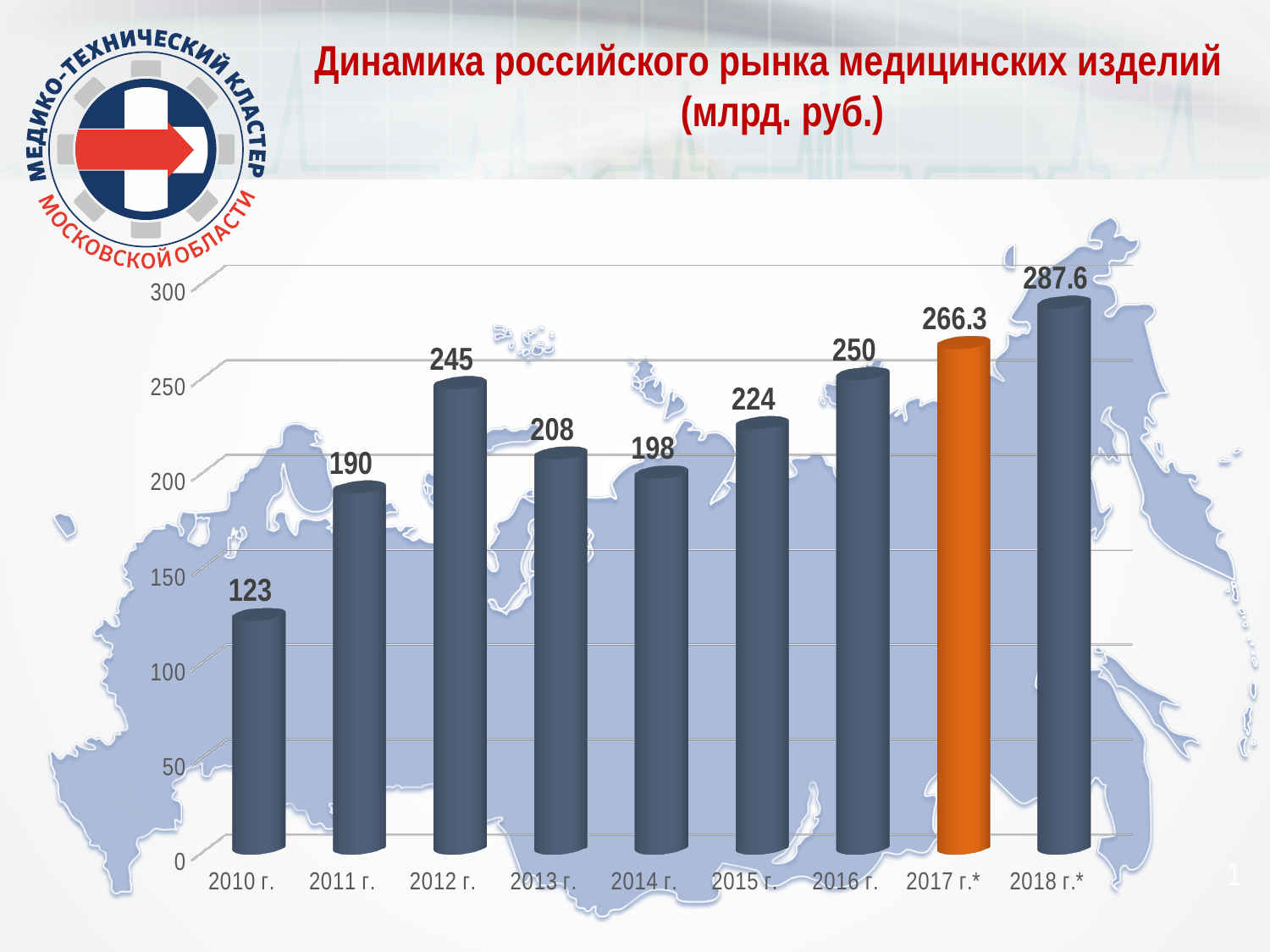
What is the value for 2010 г.? 123 Which bar is coloured orange instead of dark blue? 2017 г.* What kind of chart is shown on the slide? bar chart Is the value for 2016 г. greater or less than 200? greater Which is larger, the value for 2012 г. or the value for 2015 г.? 2012 г. What is the value for 2017 г.*? 266.3 How many years are shown on the x axis? 9 What is the value for 2014 г.? 198 Which year has the highest value? 2018 г.* What is the difference between the values for 2018 г.* and 2017 г.*? 21.3 What is the difference between the values for 2012 г. and 2013 г.? 37 Which year has the lowest value? 2010 г.